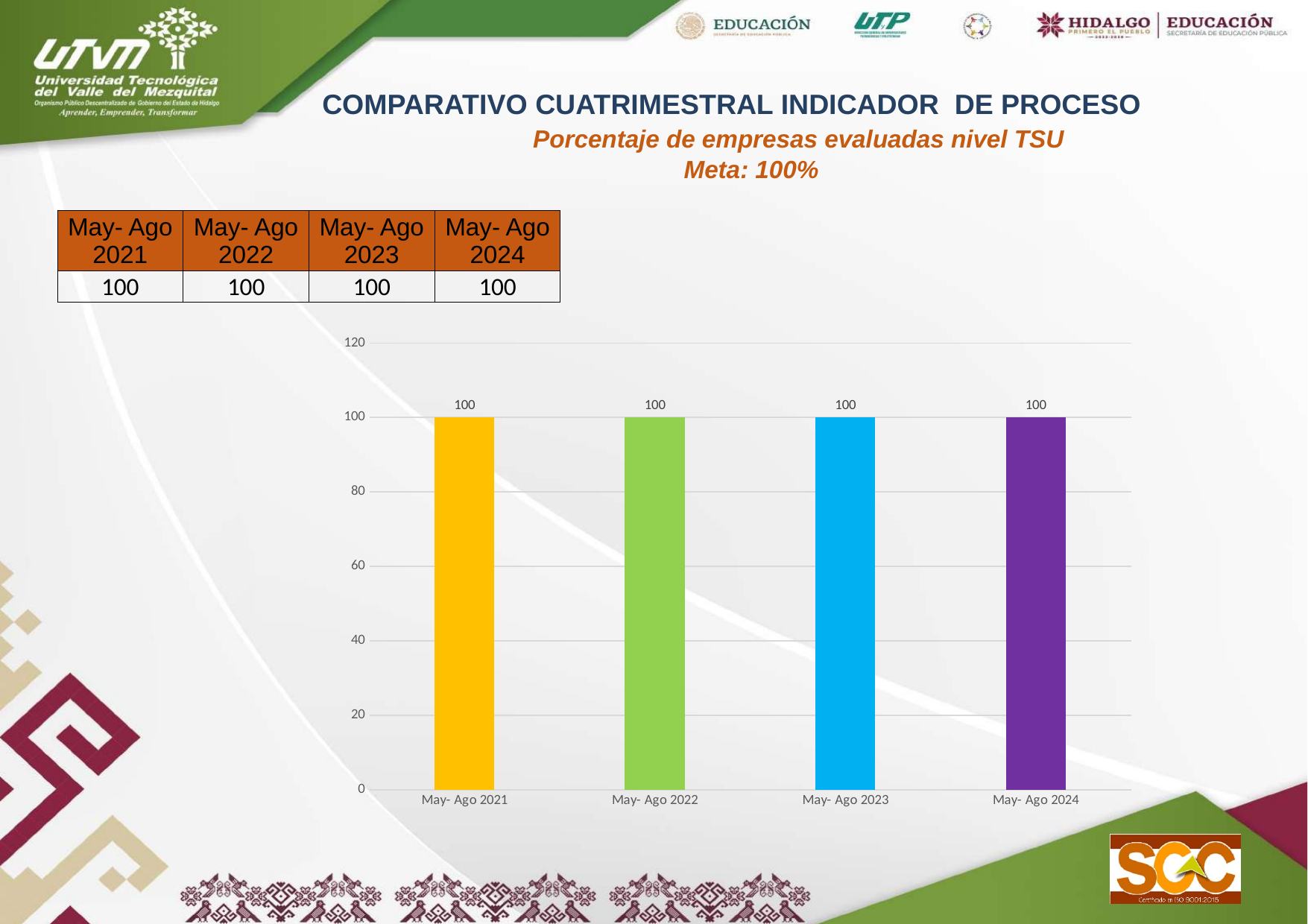
What kind of chart is shown on the slide? Bar chart What is the difference between the values for May- Ago 2024 and May- Ago 2021? 0 What colour is the bar for May- Ago 2021? Yellow What target (Meta) is stated above the chart? 100% What is the value for May- Ago 2022? 100 Is the value for May- Ago 2022 greater or less than 120? less What is the value for May- Ago 2023? 100 Do the values rise, fall or stay the same from May- Ago 2021 to May- Ago 2024? Stay the same What is the value for May- Ago 2021? 100 How many categories are plotted on the x axis? 4 Is the value for May- Ago 2023 greater or less than 80? greater What is the value for May- Ago 2024? 100